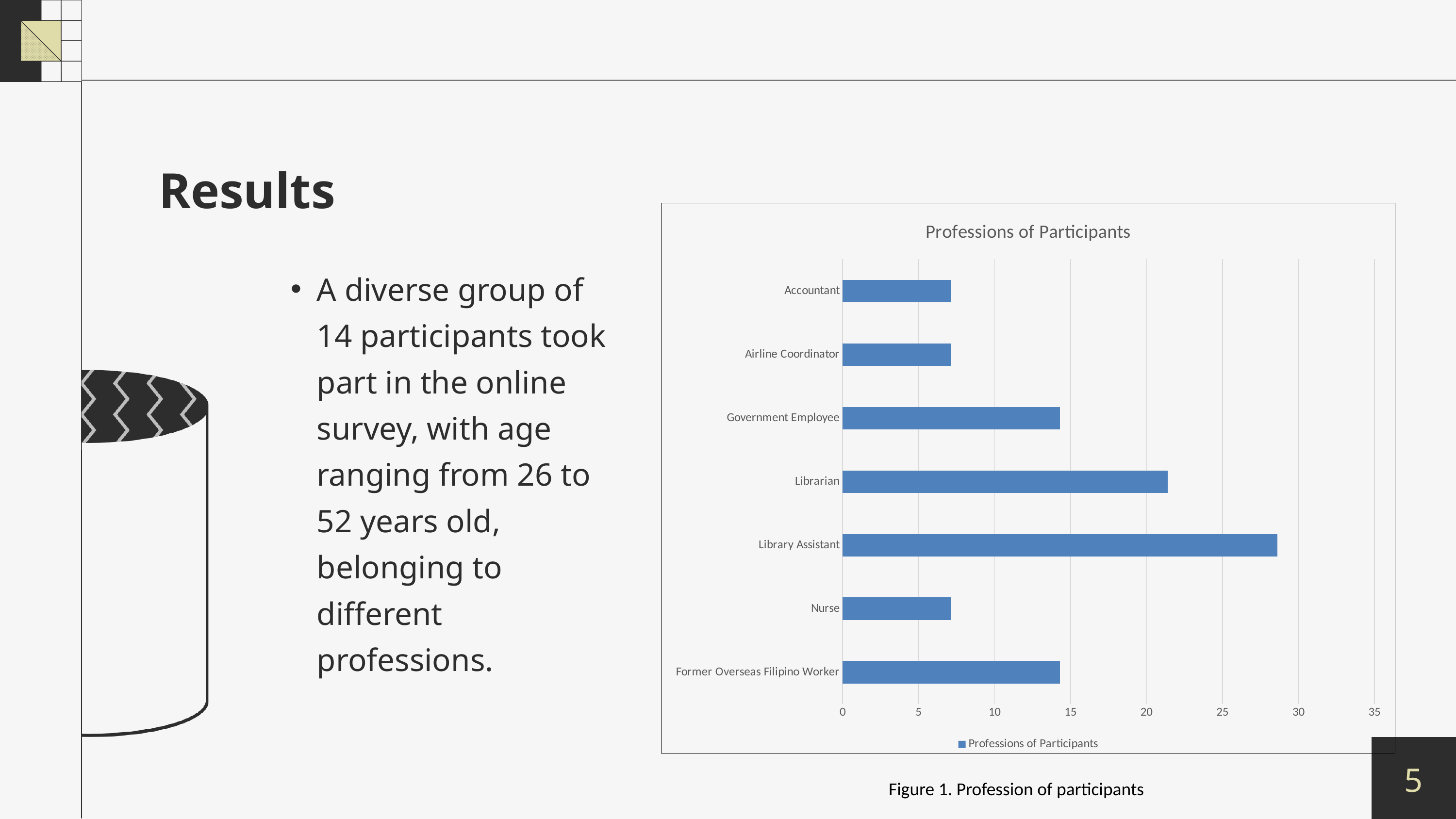
How many professions are listed on the chart? 7 Is the value for Nurse greater or less than 10? less What is the title of the chart? Professions of Participants Which profession has the highest value on the chart? Library Assistant How many series does the legend list? 1 Is the value for Librarian greater or less than 20? greater Which is larger, the value for Former Overseas Filipino Worker or the value for Airline Coordinator? Former Overseas Filipino Worker Which is larger, the value for Librarian or the value for Government Employee? Librarian Is the value for Accountant greater or less than 5? greater What kind of chart is shown on the slide? bar chart